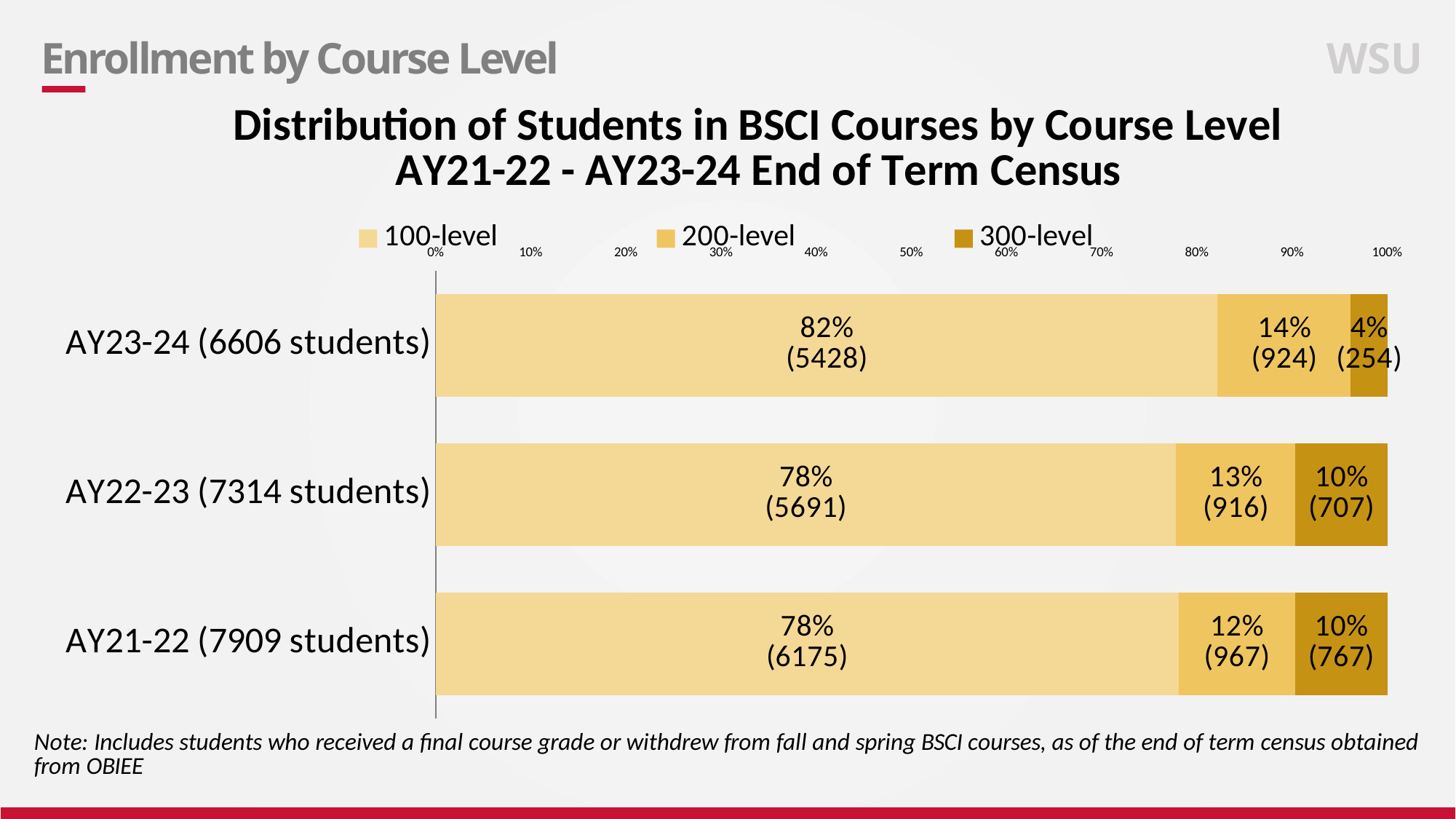
Which academic year had the highest percentage of students in 100-level courses? AY23-24 What kind of chart is shown on the slide? Stacked bar chart What is the difference in the number of 200-level students between AY21-22 and AY23-24? 43 Which academic year had the lowest percentage of students in 300-level courses? AY23-24 How many students were in 300-level courses in AY22-23? 707 What is the total number of students in AY22-23 according to the category label? 7314 How many academic years are shown in the chart? 3 What percentage of AY21-22 students were in 200-level courses? 12% What is the title of the chart? Distribution of Students in BSCI Courses by Course Level AY21-22 - AY23-24 End of Term Census How many series does the legend list? 3 Which had more 300-level students, AY21-22 or AY22-23? AY21-22 What percentage of AY23-24 students were in 100-level courses? 82%